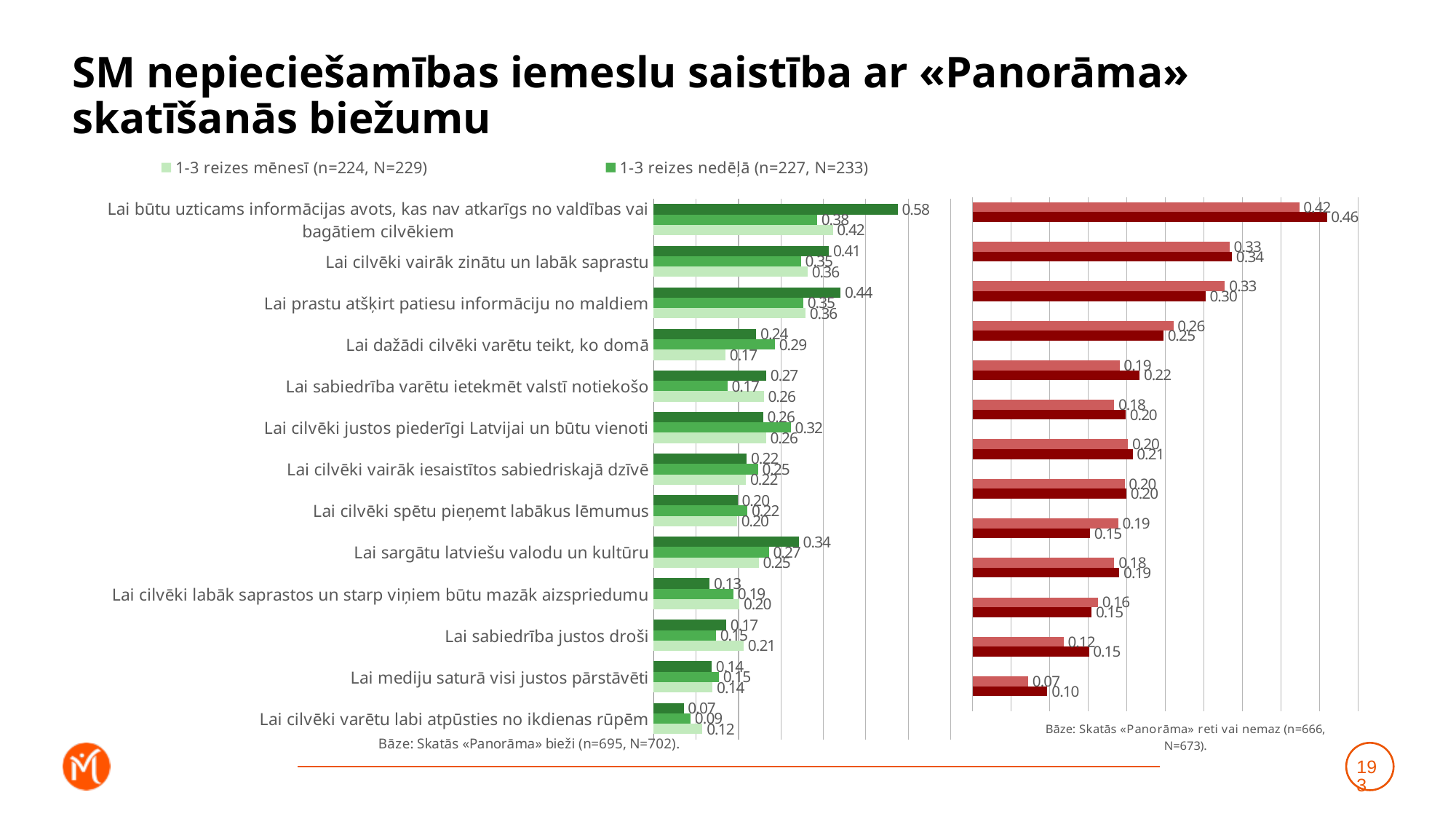
In the left (green) chart, what is the value for "1-3 reizes nedēļā" for "Lai sargātu latviešu valodu un kultūru"? 0.27 In the left (green) chart, which category has the highest value for "1-3 reizes nedēļā"? Lai būtu uzticams informācijas avots, kas nav atkarīgs no valdības vai bagātiem cilvēkiem How many categories are listed in the left (green) chart? 13 In the right (red) chart, what is the value of the lighter red bar for the bottom category? 0.07 In the left (green) chart, which category has the lowest value for "1-3 reizes mēnesī"? Lai cilvēki varētu labi atpūsties no ikdienas rūpēm In the right (red) chart, what is the value of the darker red bar for the top category? 0.46 In the left (green) chart, for "Lai dažādi cilvēki varētu teikt, ko domā", which is larger: the "1-3 reizes mēnesī" value or the "1-3 reizes nedēļā" value? 1-3 reizes nedēļā In the left (green) chart, what is the value for "1-3 reizes mēnesī" for "Lai būtu uzticams informācijas avots, kas nav atkarīgs no valdības vai bagātiem cilvēkiem"? 0.42 In the left (green) chart, what is the difference between the "1-3 reizes mēnesī" and "1-3 reizes nedēļā" values for "Lai sabiedrība justos droši"? 0.06 In the right (red) chart, what is the difference between the darker red and lighter red bars for the top category? 0.04 What kind of chart is used on this slide? Bar chart How many series does the legend at the top of the slide list? 2